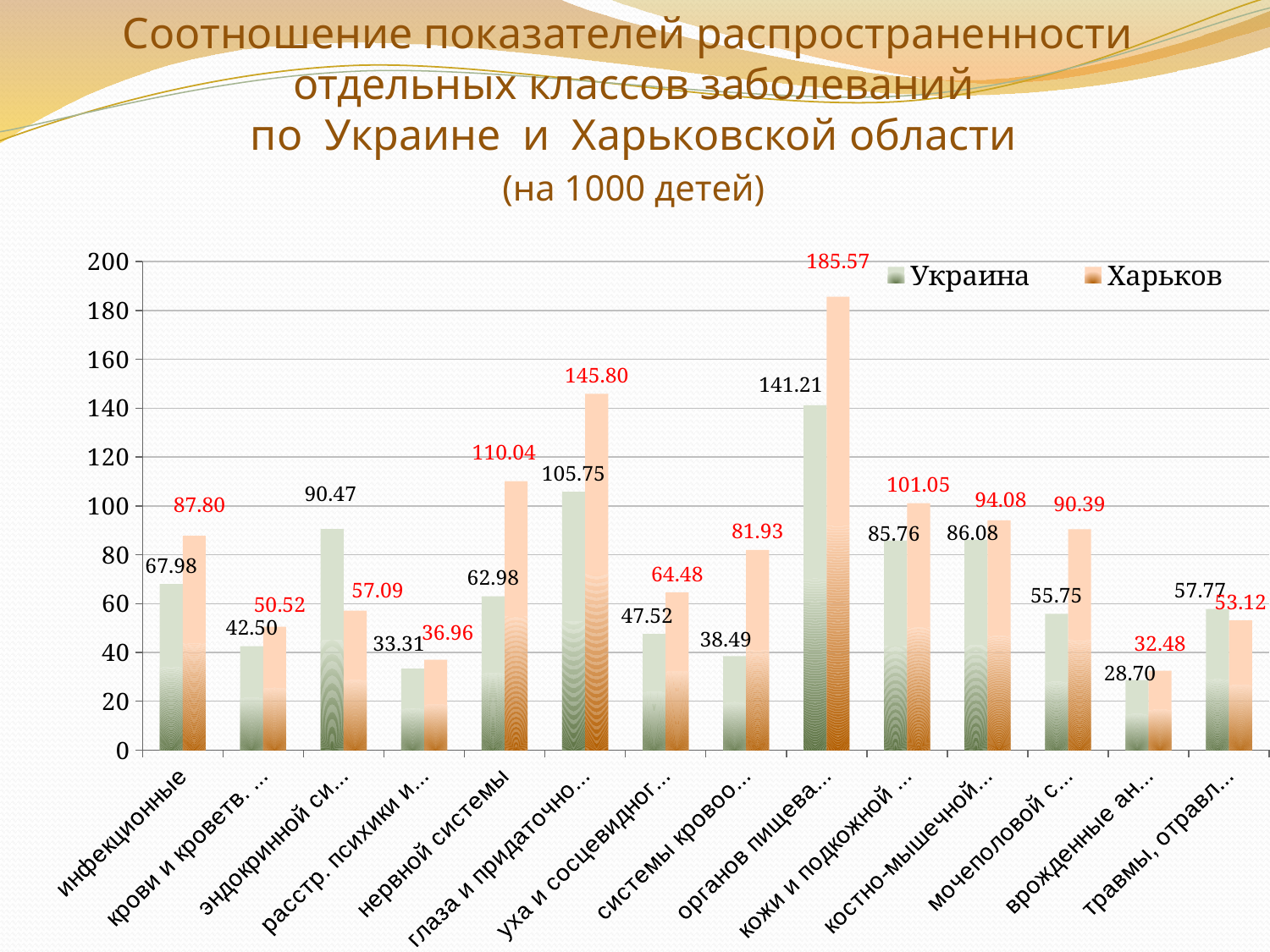
What is the value for Харьков for the category нервной системы? 110.04 For the category инфекционные, which series has the larger value, Украина or Харьков? Харьков Which category has the highest value for the Харьков series? органов пищева... How many series does the legend list? 2 Which category has the lowest value for the Украина series? врожденные ан... What are the two series named in the legend? Украина and Харьков What is the value for Украина for the category инфекционные? 67.98 What kind of chart is shown on the slide? bar chart What is the value for Харьков for the category инфекционные? 87.80 For the category эндокринной си..., which series has the larger value, Украина or Харьков? Украина What is the difference between the Харьков and Украина values for the category нервной системы? 47.06 How many categories are shown on the x axis? 14